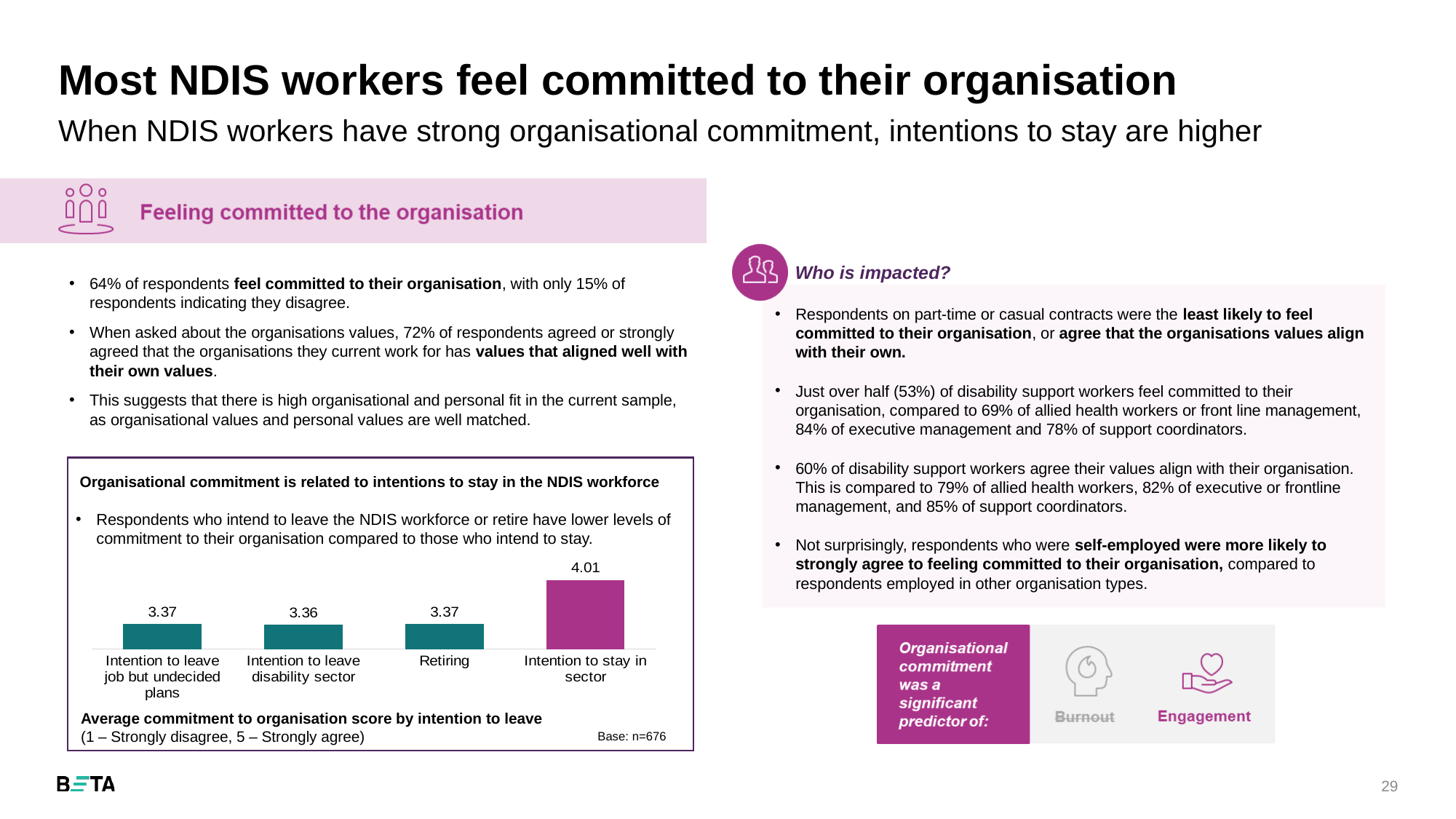
Which bar in the chart is coloured differently (magenta) from the other teal bars? Intention to stay in sector What is the difference between the average commitment score for 'Intention to stay in sector' and 'Intention to leave disability sector'? 0.65 What is the average commitment score for respondents with an intention to stay in the sector? 4.01 Which intention group has the highest average commitment to organisation score? Intention to stay in sector What is the average commitment score for respondents who are retiring? 3.37 How many intention categories are shown in the chart? 4 What is the average commitment score for respondents with an intention to leave the disability sector? 3.36 What is the base sample size (n) stated for the chart? n=676 Which has a larger average commitment score: 'Intention to stay in sector' or 'Intention to leave job but undecided plans'? Intention to stay in sector What is the difference between the average commitment score for 'Intention to stay in sector' and 'Retiring'? 0.64 What type of chart is used to show average commitment to organisation score by intention to leave? Bar chart What is the average commitment score for respondents with an intention to leave their job but undecided plans? 3.37